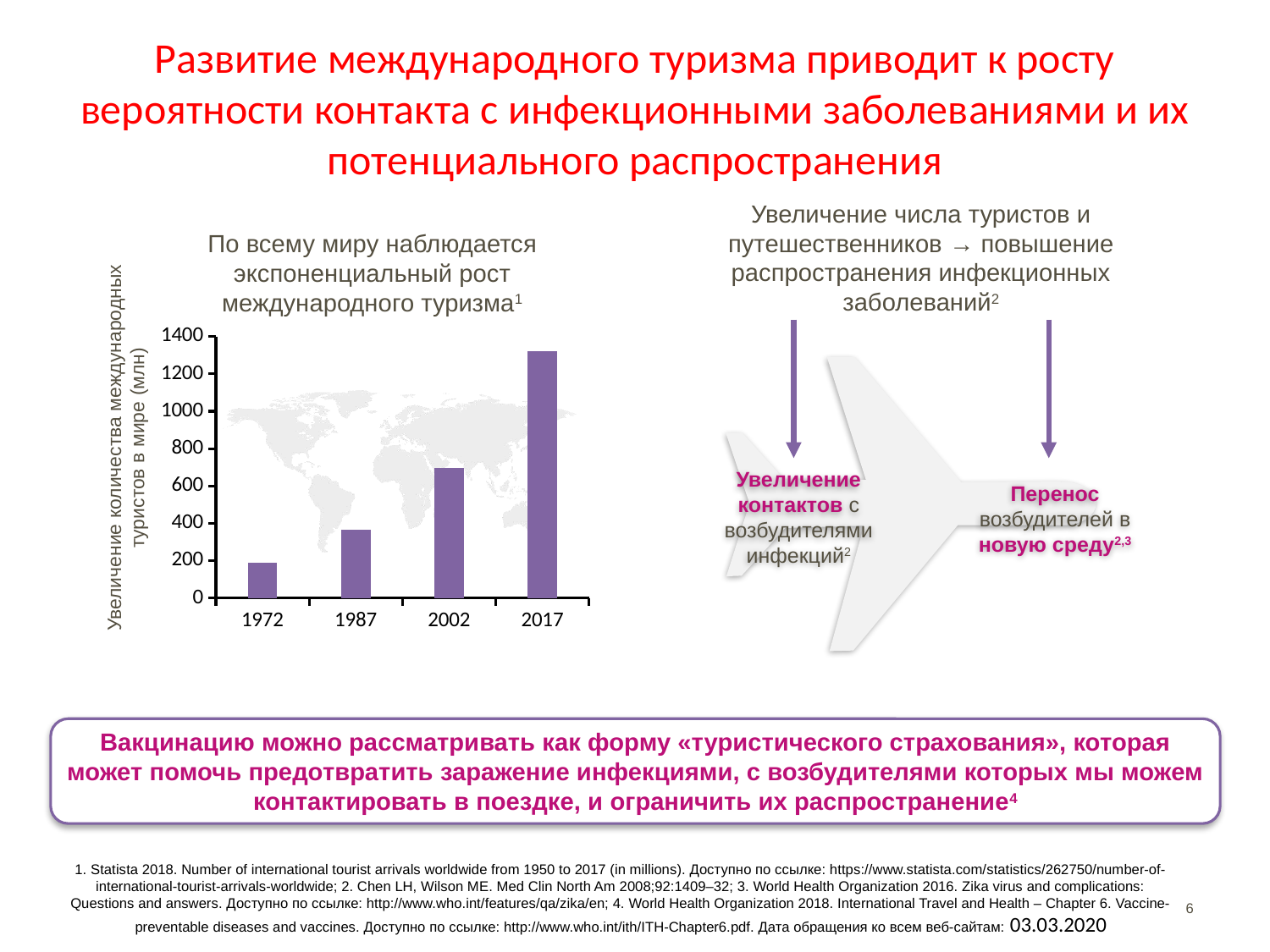
Which year has the highest bar in the chart? 2017 Is the value for 2017 greater or less than 1200? greater Which year has the larger value, 1987 or 2002? 2002 How many years are shown on the x axis of the bar chart? 4 What is the title of the bar chart? По всему миру наблюдается экспоненциальный рост международного туризма Is the value for 2002 greater or less than 600? greater What kind of chart is shown on the slide? bar chart Do the values rise or fall from 1972 to 2017? rise What is the maximum value shown on the y axis of the chart? 1400 Is the value for 1972 greater or less than 400? less Which year has the lowest bar in the chart? 1972